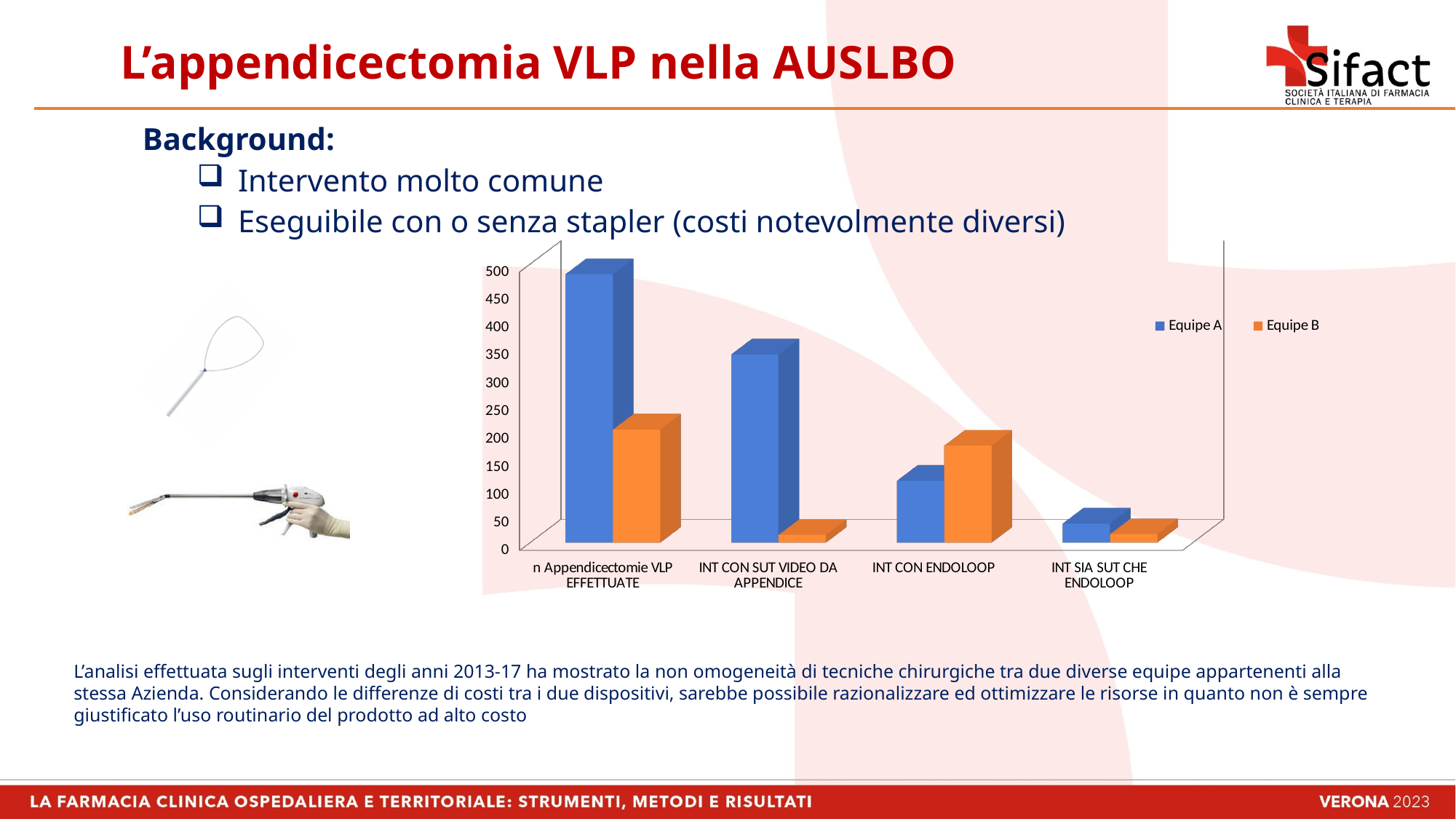
How many series does the chart legend list? 2 Which category has the highest value for Equipe B? n Appendicectomie VLP EFFETTUATE Do the values for Equipe A rise or fall from left to right along the x axis? fall For INT CON ENDOLOOP, which series has the larger value, Equipe A or Equipe B? Equipe B How many categories are shown on the x axis of the chart? 4 For INT CON SUT VIDEO DA APPENDICE, which series has the larger value, Equipe A or Equipe B? Equipe A Is the value for Equipe B in INT CON SUT VIDEO DA APPENDICE greater or less than 100? less Is the value for Equipe A in n Appendicectomie VLP EFFETTUATE greater or less than 400? greater What kind of chart is shown on the slide? bar chart Which category has the lowest value for Equipe A? INT SIA SUT CHE ENDOLOOP Which category has the highest value for Equipe A? n Appendicectomie VLP EFFETTUATE